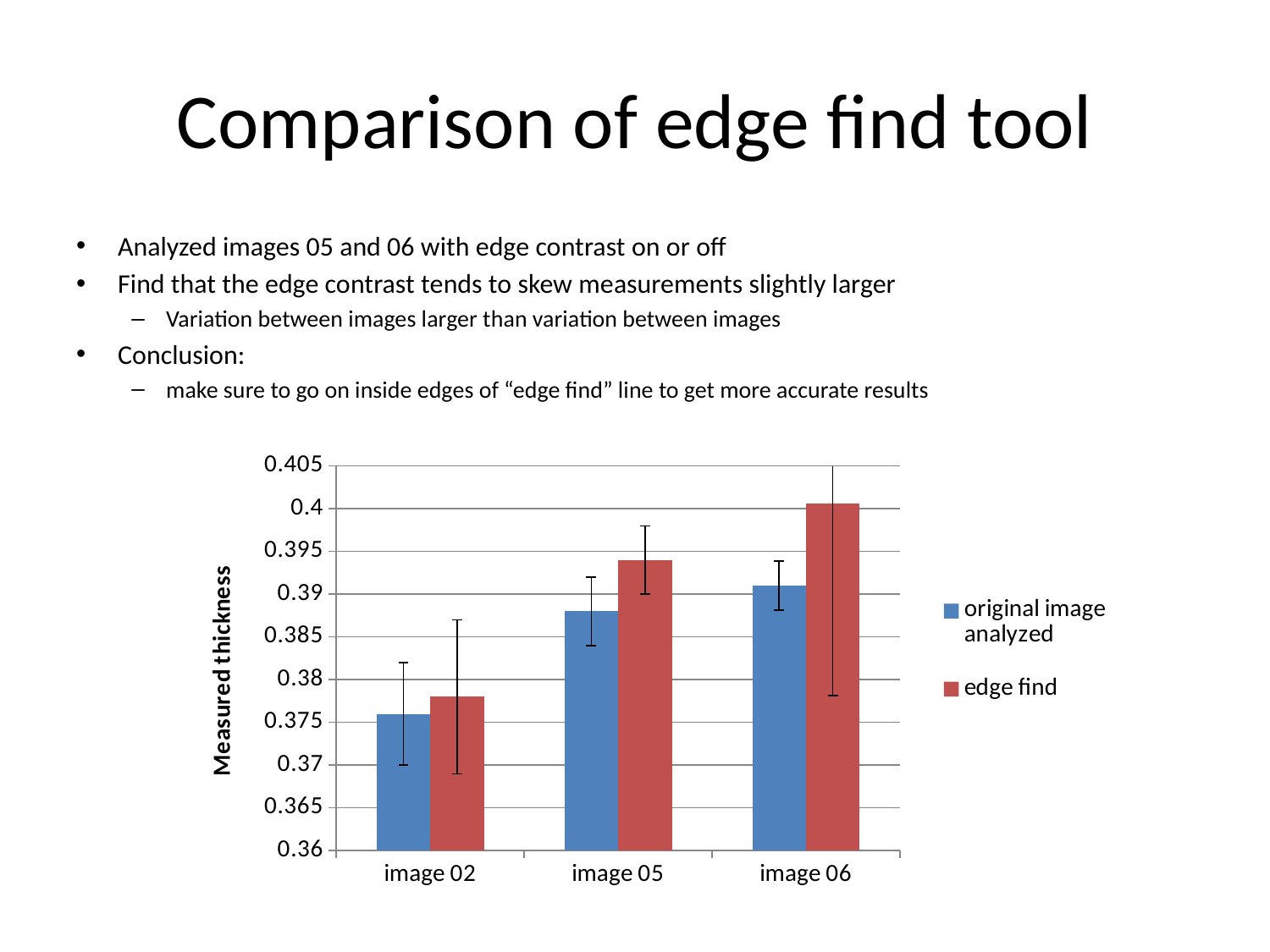
How many series does the chart's legend list? 2 What kind of chart is shown on the slide? bar chart What is the title of the chart's vertical axis? Measured thickness Do the 'edge find' values rise or fall from image 02 to image 06? rise Which image has the lowest 'original image analyzed' measured thickness? image 02 Which image has the lowest 'edge find' measured thickness? image 02 Which image has the highest 'edge find' measured thickness? image 06 Is the 'edge find' value for image 06 greater or less than 0.395? greater What are the two series named in the chart's legend? original image analyzed; edge find Is the 'original image analyzed' value for image 02 greater or less than 0.38? less For image 05, which is larger: the 'original image analyzed' value or the 'edge find' value? edge find How many image categories are shown on the x axis of the chart? 3